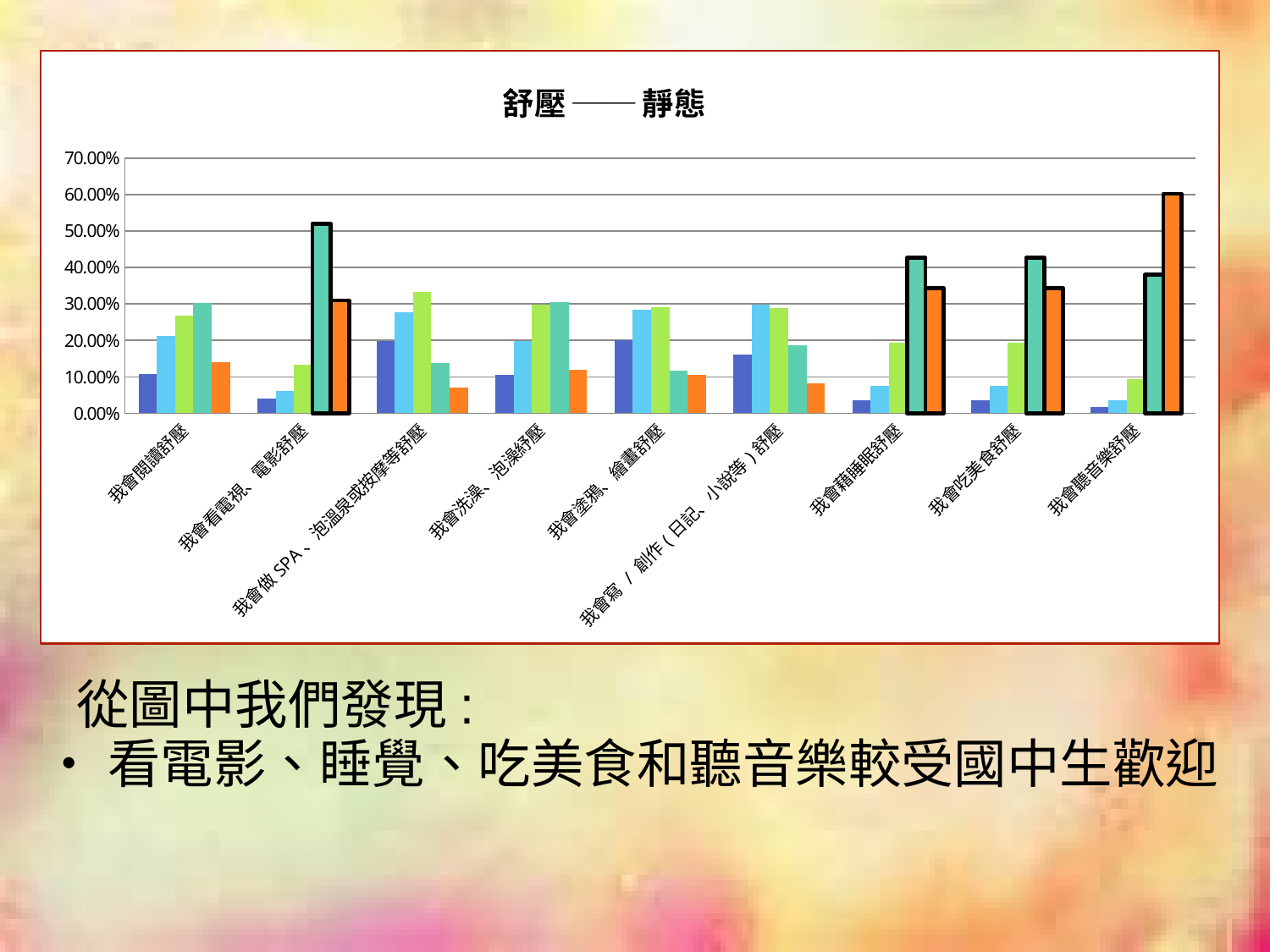
Which has the larger teal bar: 我會看電視、電影舒壓 or 我會聽音樂舒壓? 我會看電視、電影舒壓 Is the value of the teal bar for 我會看電視、電影舒壓 greater or less than 40.00%? greater What is the highest value shown on the y axis of the chart? 70.00% How many categories are shown on the x axis of the chart? 9 Which has the larger orange bar: 我會閱讀舒壓 or 我會聽音樂舒壓? 我會聽音樂舒壓 Is the value of the dark blue bar for 我會聽音樂舒壓 greater or less than 10.00%? less What kind of chart is shown on the slide? bar chart How many bars are plotted for each category in the chart? 5 Is the value of the teal bar for 我會藉睡眠舒壓 greater or less than 30.00%? greater What is the title of the chart? 舒壓 —— 靜態 Which category contains the tallest bar in the chart? 我會聽音樂舒壓